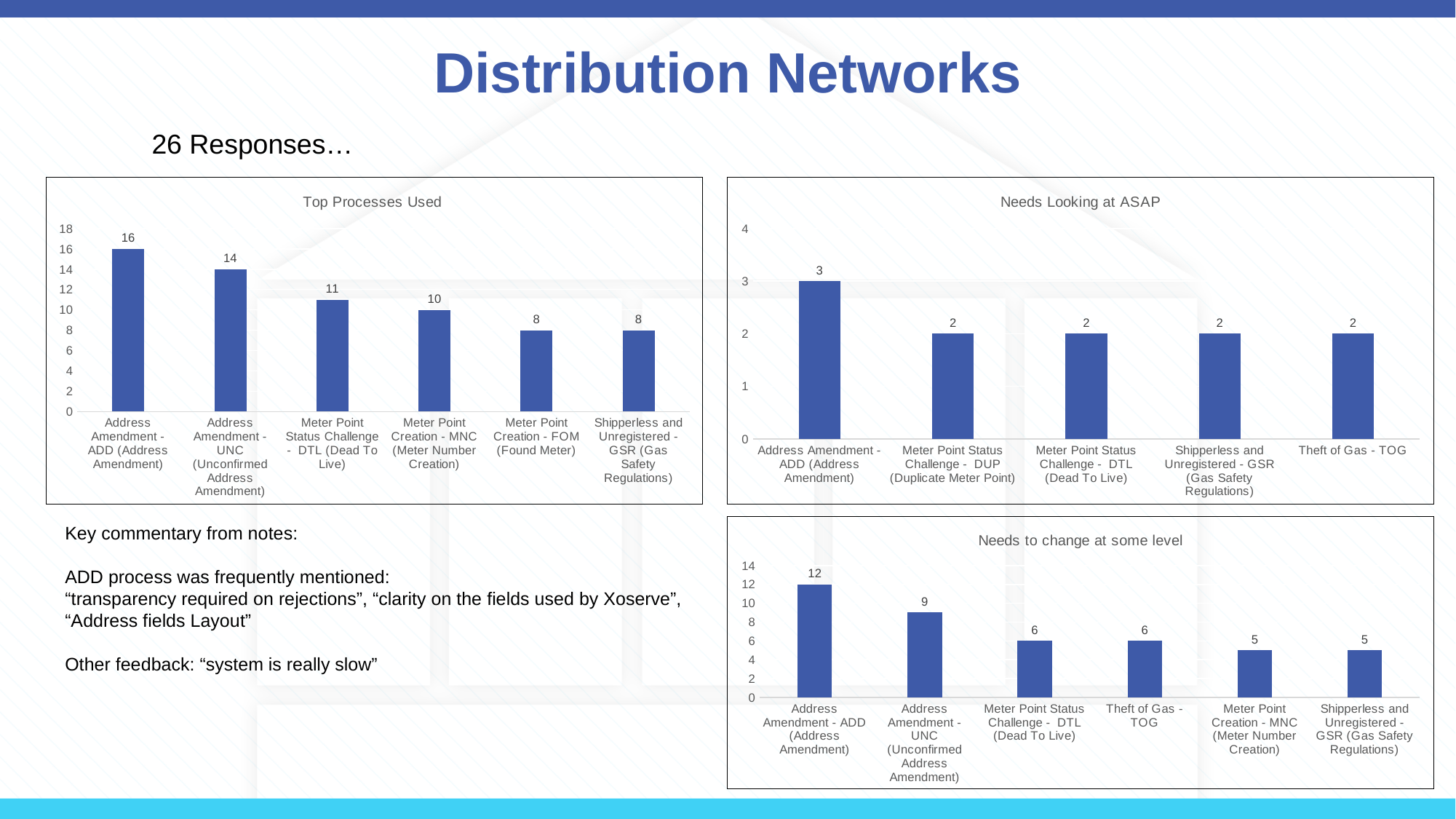
In the 'Needs Looking at ASAP' chart, how many categories are shown? 5 In the 'Needs to change at some level' chart, what is the value for Theft of Gas - TOG? 6 What type of chart is 'Needs to change at some level'? Bar chart In the 'Needs Looking at ASAP' chart, what is the value for Address Amendment - ADD (Address Amendment)? 3 In the 'Top Processes Used' chart, which category has the highest value? Address Amendment - ADD (Address Amendment) In the 'Needs to change at some level' chart, do the values rise or fall from left to right? Fall In the 'Top Processes Used' chart, what is the value for Address Amendment - ADD (Address Amendment)? 16 In the 'Top Processes Used' chart, how many categories are shown? 6 In the 'Top Processes Used' chart, what is the difference between Address Amendment - UNC and Meter Point Creation - MNC? 4 In the 'Needs Looking at ASAP' chart, which category has the highest value? Address Amendment - ADD (Address Amendment) In the 'Needs to change at some level' chart, which is larger: Address Amendment - UNC or Meter Point Creation - MNC? Address Amendment - UNC In the 'Needs to change at some level' chart, what is the difference between Address Amendment - ADD and Address Amendment - UNC? 3